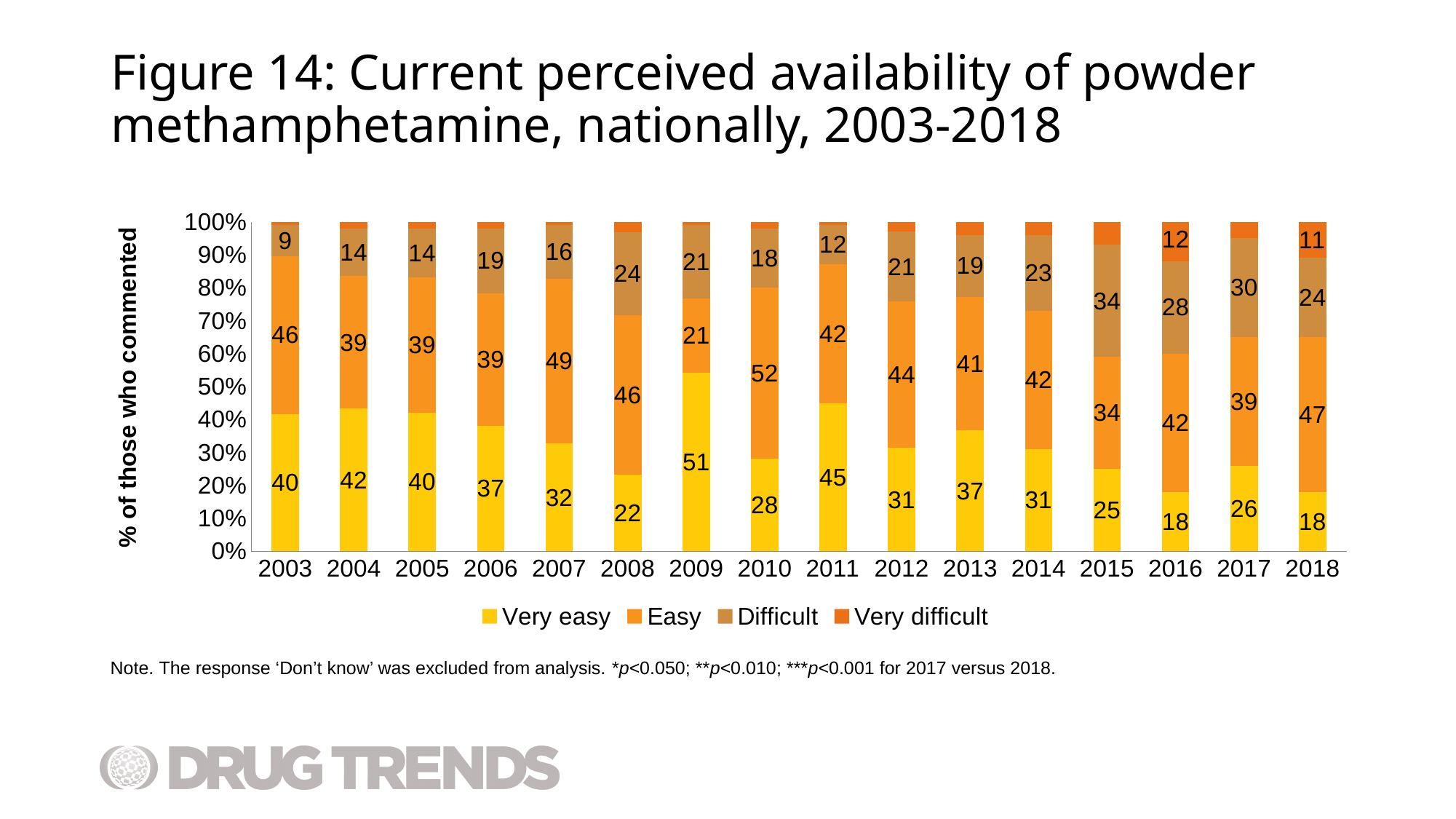
What is the 'Easy' value for 2018? 47 What kind of chart is shown on the slide? Stacked bar chart What percentage of respondents rated powder methamphetamine as 'Very easy' to obtain in 2009? 51 How many series does the legend list? 4 What is the 'Difficult' value for 2015? 34 In which year is the 'Difficult' value lowest? 2003 Does the 'Very easy' value rise or fall from 2014 to 2016? Fall Which is larger in 2018, the 'Easy' value or the 'Very easy' value? Easy In which year is the 'Very easy' value highest? 2009 How many years are shown on the x axis? 16 In which year is the 'Easy' value highest? 2010 What is the difference between the 'Very easy' value in 2003 and in 2018? 22